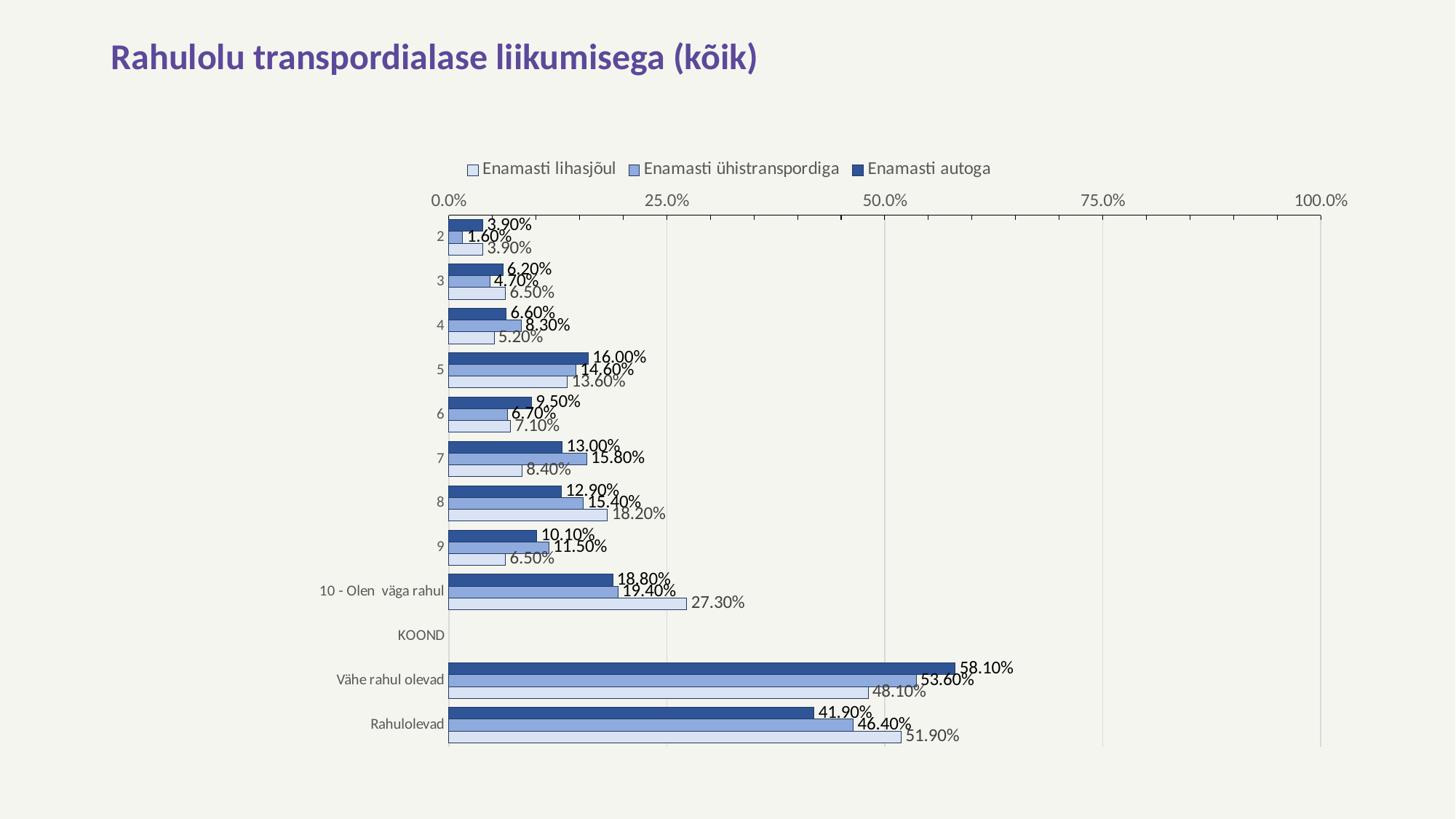
Is the value for Enamasti autoga in the Vähe rahul olevad category greater or less than 50.0%? greater How many series does the legend list? 3 What is the value for Enamasti lihasjõul in the Rahulolevad category? 51.90% What is the value for Enamasti lihasjõul in category 8? 18.20% What is the title of the chart? Rahulolu transpordialase liikumisega (kõik) What is the value for Enamasti ühistranspordiga in the 10 - Olen väga rahul category? 19.40% What is the difference between the Enamasti autoga and Enamasti lihasjõul values in the Vähe rahul olevad category? 10.00% What kind of chart is shown on the slide? bar chart Which series has the highest value in the Rahulolevad category? Enamasti lihasjõul Which series has the lowest value in category 2? Enamasti ühistranspordiga What is the value for Enamasti autoga in the Vähe rahul olevad category? 58.10% Which is larger in category 7: Enamasti ühistranspordiga or Enamasti autoga? Enamasti ühistranspordiga